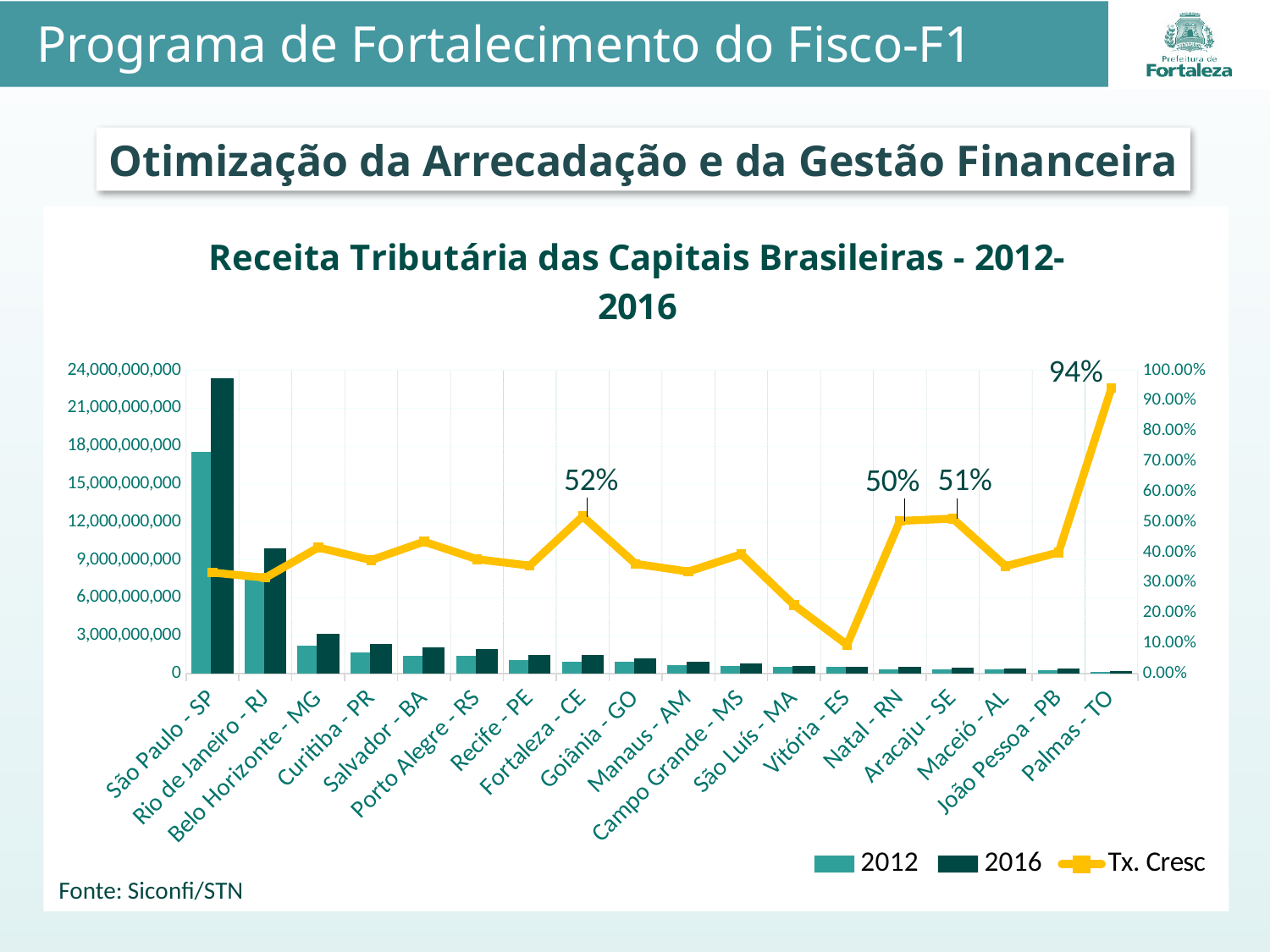
How many capitals are shown on the x axis of the chart? 18 Which capital has the tallest 2016 bar? São Paulo - SP What is the Tx. Cresc value shown for Palmas - TO? 94% What is the difference between the Tx. Cresc values for Palmas - TO and Fortaleza - CE? 42% What is the Tx. Cresc value shown for Fortaleza - CE? 52% How many series does the chart legend list? 3 Is the 2016 value for Rio de Janeiro - RJ greater or less than 12,000,000,000? less Which capital has the highest Tx. Cresc value? Palmas - TO Which has the higher Tx. Cresc value, Natal - RN or Aracaju - SE? Aracaju - SE What is the Tx. Cresc value shown for Natal - RN? 50% Which capital has the lowest Tx. Cresc value? Vitória - ES Is the 2016 value for São Paulo - SP greater or less than 21,000,000,000? greater